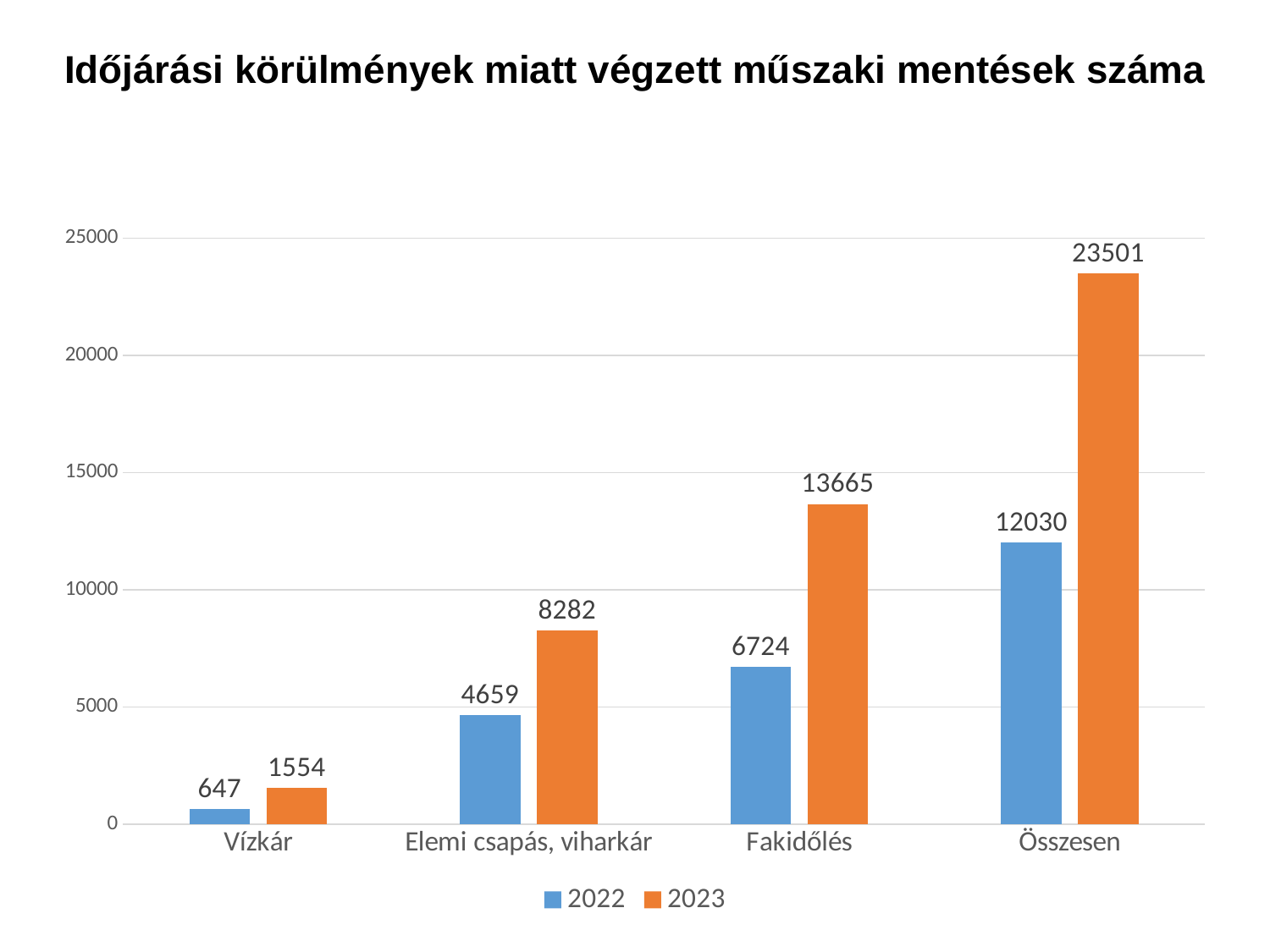
Is the 2022 value for Összesen greater or less than 10000? greater What is the value for Elemi csapás, viharkár in 2023? 8282 What is the difference between the 2023 and 2022 values for Összesen? 11471 How many categories are shown on the x axis? 4 What is the value for Fakidőlés in 2023? 13665 What kind of chart is shown on the slide? bar chart What is the difference between the 2023 and 2022 values for Fakidőlés? 6941 Which category has the highest value in 2023? Összesen What is the value for Vízkár in 2022? 647 Which category has the lowest value in 2022? Vízkár Which is larger: the 2022 value for Fakidőlés or the 2023 value for Elemi csapás, viharkár? 2023 value for Elemi csapás, viharkár How many series does the legend list? 2